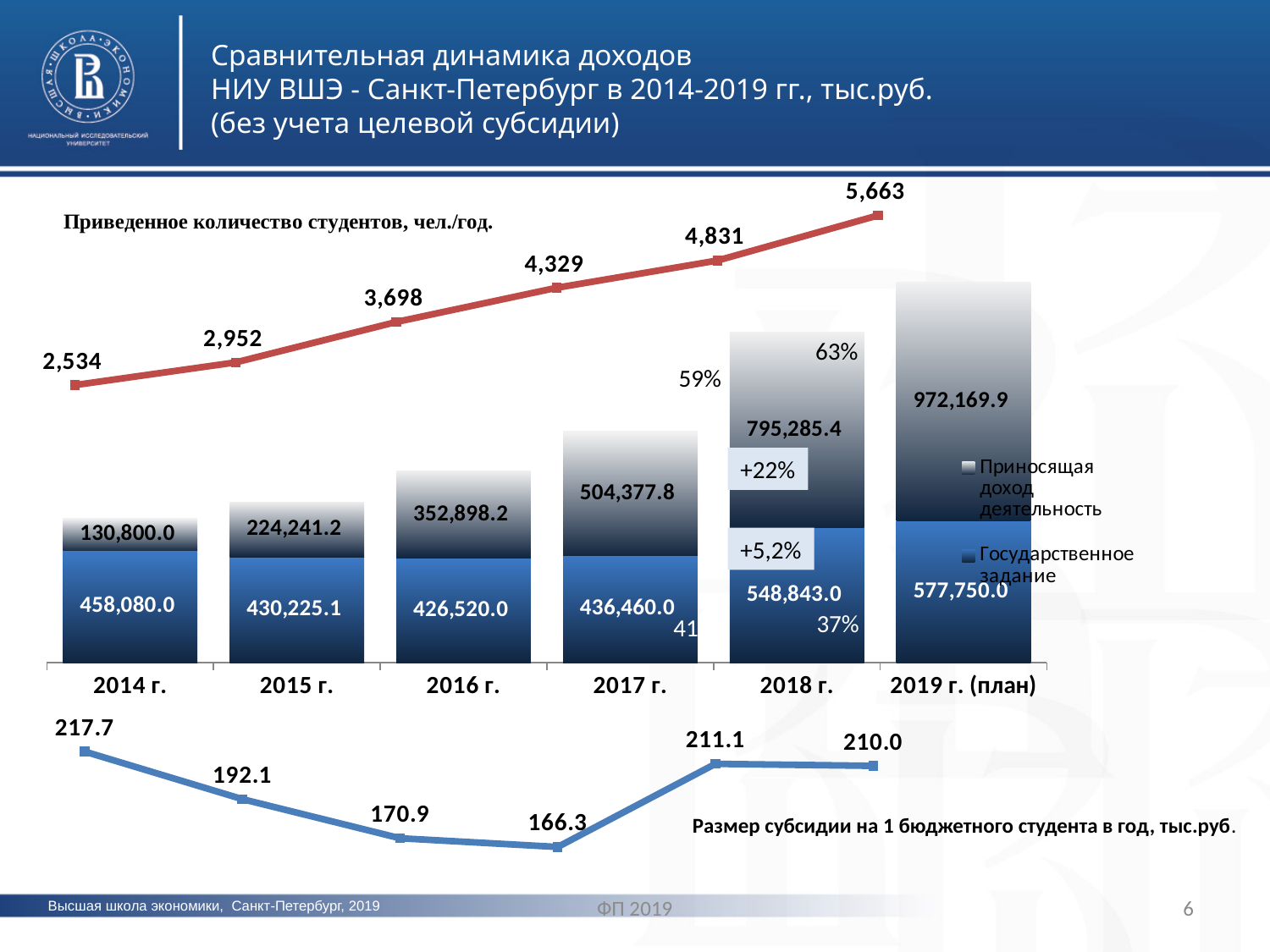
In the line 'Приведенное количество студентов, чел./год.', what is the difference between the 2019 г. (план) and 2014 г. values? 3,129 In the line 'Размер субсидии на 1 бюджетного студента в год, тыс.руб.', do the values rise or fall from 2014 г. to 2017 г.? fall In the line 'Приведенное количество студентов, чел./год.', what is the value for 2017 г.? 4,329 In the stacked bar chart, which year has the lowest value for Государственное задание? 2016 г. How many years are shown on the x axis of the stacked bar chart? 6 In the line 'Размер субсидии на 1 бюджетного студента в год, тыс.руб.', which year has the lowest value? 2017 г. In the stacked bar chart, what is the value of Приносящая доход деятельность for 2019 г. (план)? 972,169.9 How many series does the legend of the stacked bar chart list? 2 In the stacked bar chart, what is the total of the two segments for 2014 г.? 588,880.0 In the stacked bar chart, what is the value of Государственное задание for 2014 г.? 458,080.0 In the stacked bar chart, which year has the highest value for Приносящая доход деятельность? 2019 г. (план) In the stacked bar chart, which is larger in 2017 г.: Приносящая доход деятельность or Государственное задание? Приносящая доход деятельность